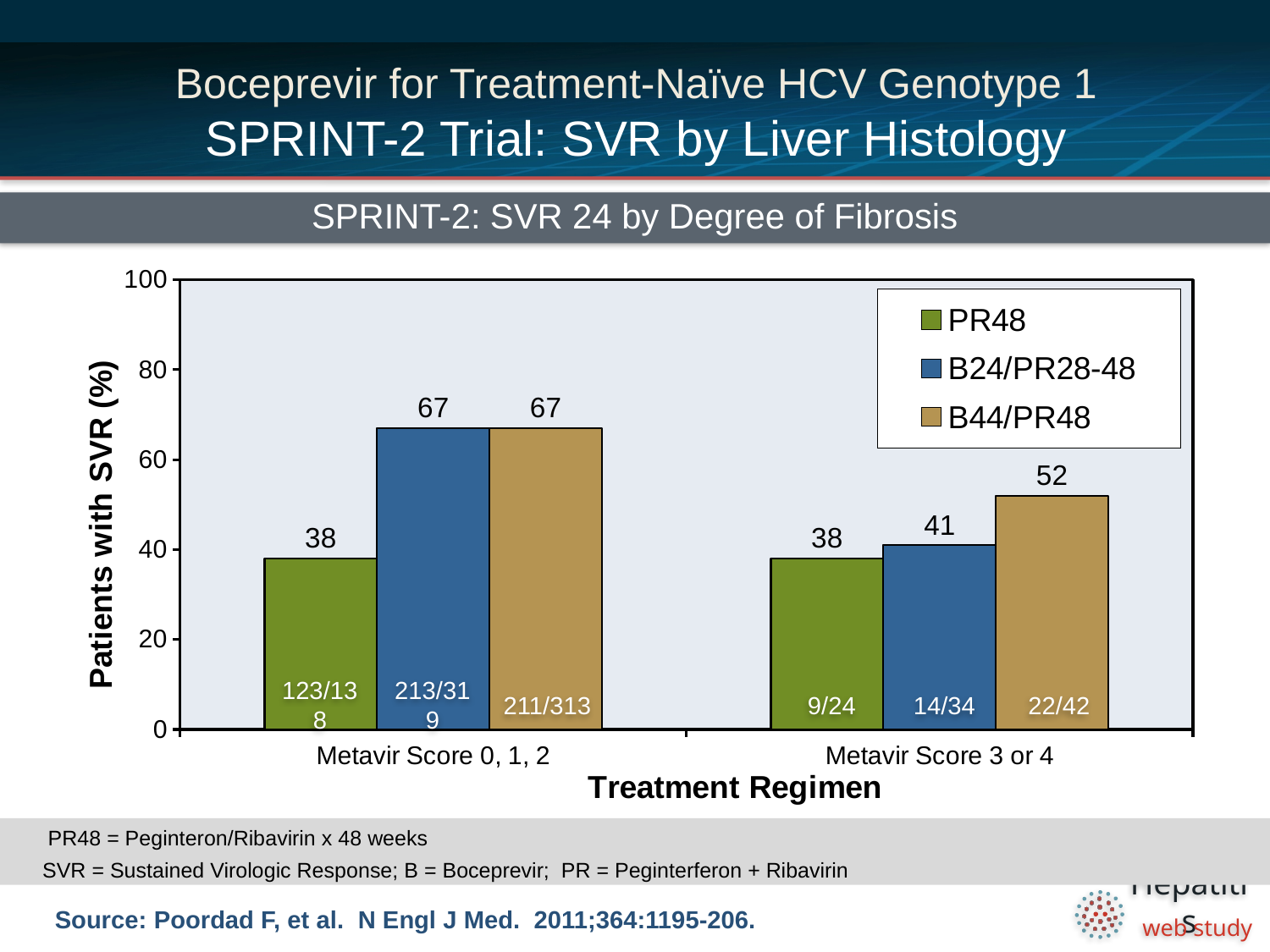
How many treatment regimens are listed in the legend? 3 What is the SVR value for PR48 in the Metavir Score 0, 1, 2 group? 38 What is the title of the chart? SPRINT-2: SVR 24 by Degree of Fibrosis How many Metavir score categories are shown on the x axis? 2 What type of chart is shown on the slide? Bar chart Is the SVR for B24/PR28-48 higher in the Metavir Score 0, 1, 2 group or the Metavir Score 3 or 4 group? Metavir Score 0, 1, 2 What is the difference between the B44/PR48 SVR values for Metavir Score 0, 1, 2 and Metavir Score 3 or 4? 15 Which treatment regimen has the lowest SVR in the Metavir Score 3 or 4 group? PR48 What is the difference between the B24/PR28-48 and PR48 SVR values in the Metavir Score 0, 1, 2 group? 29 What is the SVR value for B24/PR28-48 in the Metavir Score 3 or 4 group? 41 What is the SVR value for B44/PR48 in the Metavir Score 3 or 4 group? 52 Which treatment regimen has the highest SVR in the Metavir Score 3 or 4 group? B44/PR48